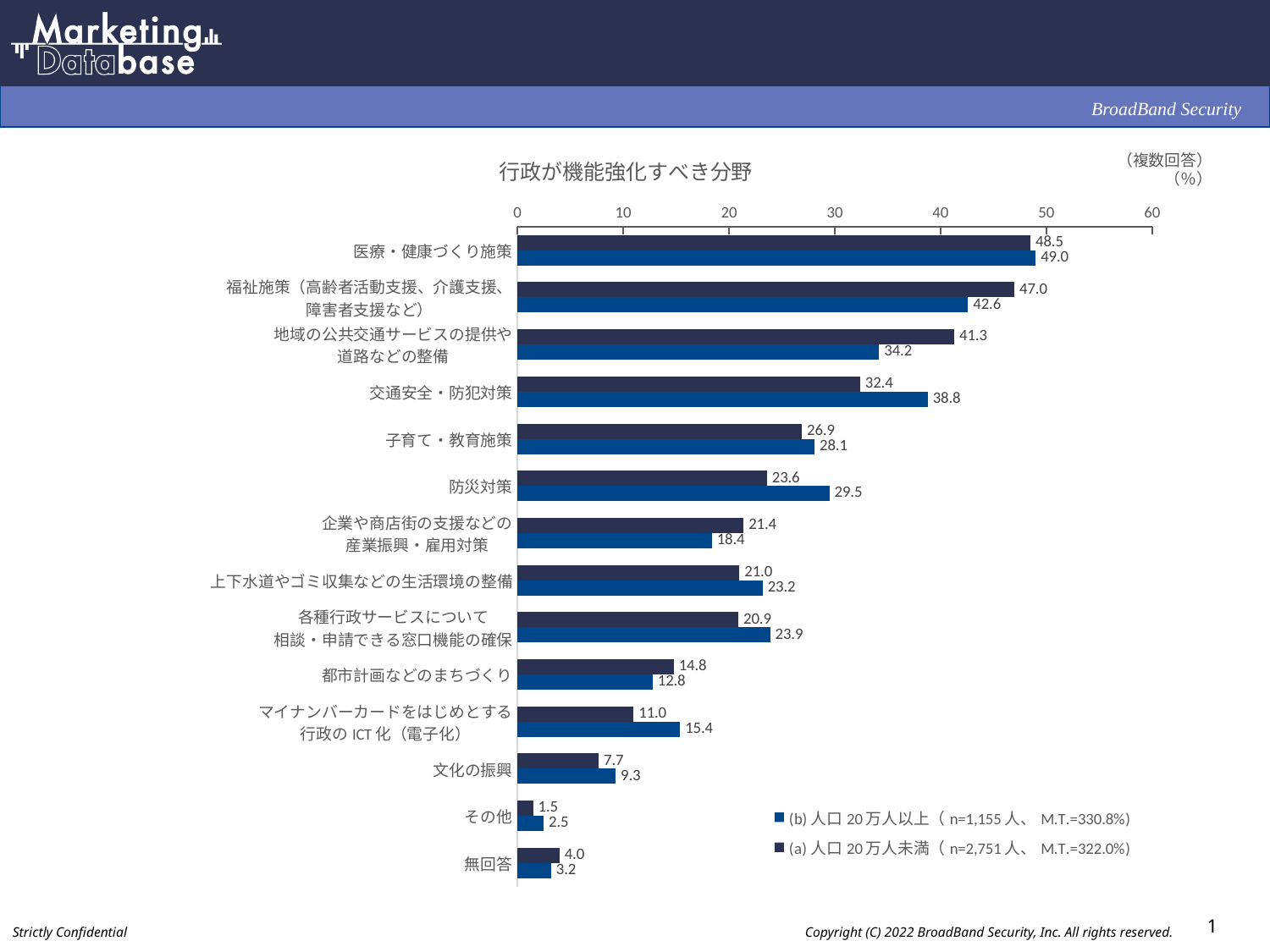
Is the value for 福祉施策（高齢者活動支援、介護支援、障害者支援など） in the (a) 人口20万人未満 series greater or less than 40? greater For 防災対策, which series has the larger value, (b) 人口20万人以上 or (a) 人口20万人未満? (b) 人口20万人以上 How many categories are plotted on the chart? 14 What is the value for 交通安全・防犯対策 in the (b) 人口20万人以上 series? 38.8 What is the value for 医療・健康づくり施策 in the (a) 人口20万人未満 series? 48.5 Which category has the lowest value in the (a) 人口20万人未満 series? その他 What is the value for マイナンバーカードをはじめとする行政のICT化（電子化） in the (a) 人口20万人未満 series? 11.0 What is the difference between the (b) 人口20万人以上 and (a) 人口20万人未満 values for 地域の公共交通サービスの提供や道路などの整備? 7.1 What is the sample size (n) shown in the legend for the (a) 人口20万人未満 series? 2,751人 How many series does the legend list? 2 Which category has the highest value in the (b) 人口20万人以上 series? 医療・健康づくり施策 What type of chart is shown on the slide? bar chart